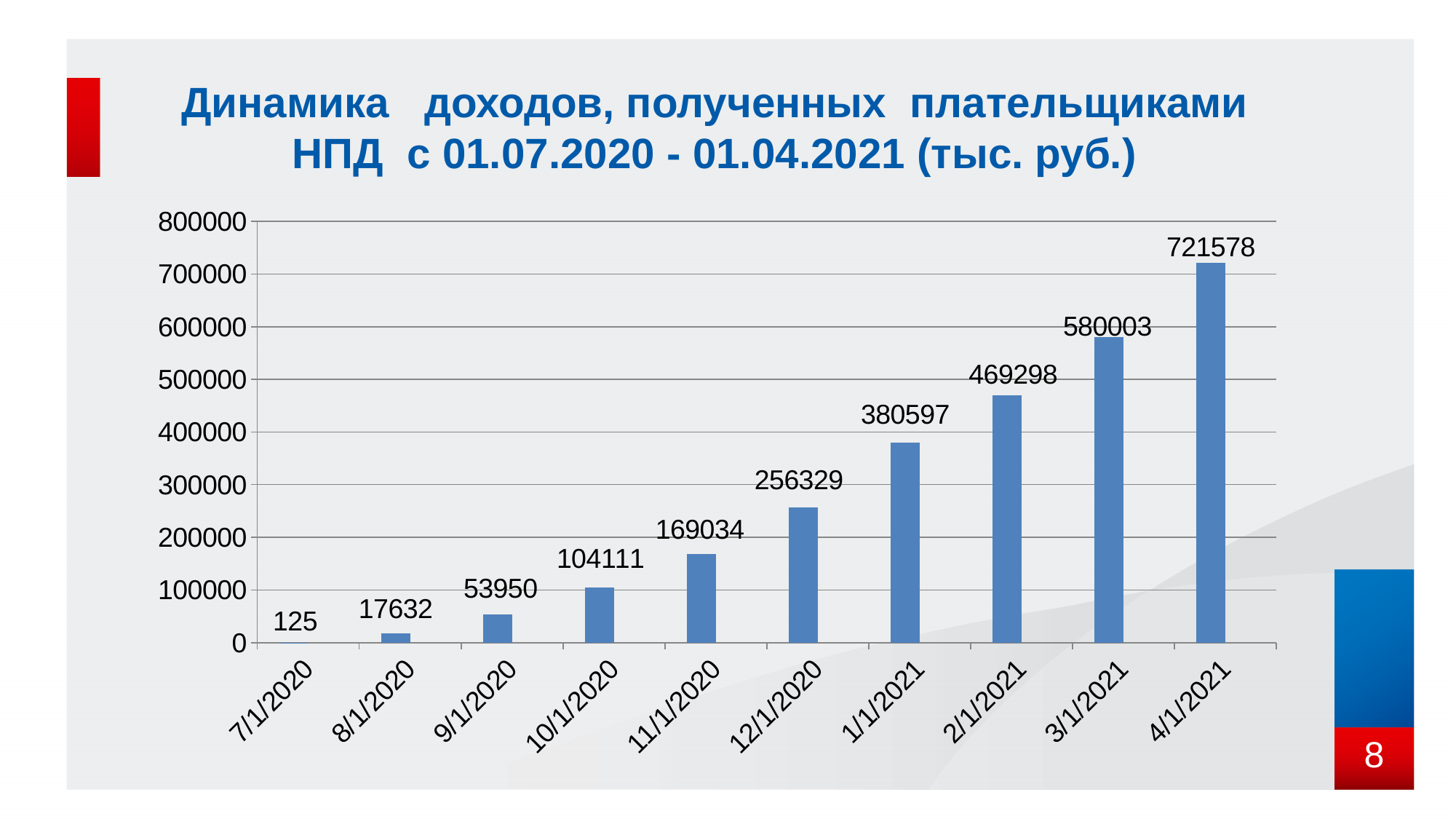
Is the value for 11/1/2020 greater or less than 200000? less Which date has the highest value? 4/1/2021 What is the difference between the values for 10/1/2020 and 9/1/2020? 50161 What is the value for 12/1/2020? 256329 What is the value for 8/1/2020? 17632 What is the value for 3/1/2021? 580003 What kind of chart is shown on the slide? bar chart Which date has the lowest value? 7/1/2020 Which is larger, the value for 1/1/2021 or the value for 2/1/2021? 2/1/2021 What is the difference between the values for 4/1/2021 and 3/1/2021? 141575 Do the values rise or fall from 7/1/2020 to 4/1/2021? rise How many dates are shown on the x axis? 10